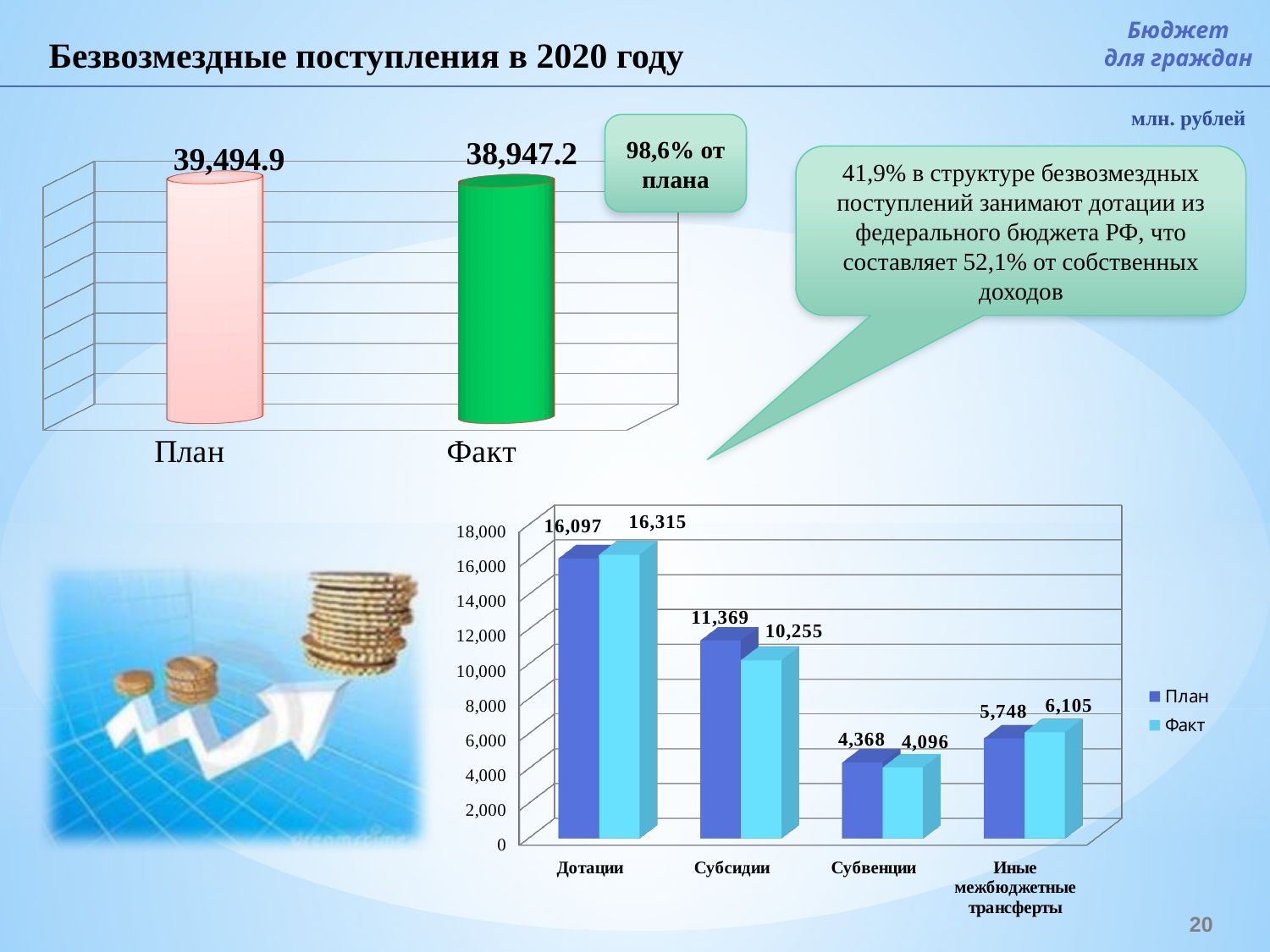
In the bottom chart, which category has the highest План value? Дотации In the top chart, what is the difference between План and Факт? 547.7 In the top chart, which is larger, План or Факт? План In the bottom chart, what is the difference between the План and Факт values for Субсидии? 1,114 In the bottom chart, which category has the lowest Факт value? Субвенции In the bottom chart, what is the Факт value for Иные межбюджетные трансферты? 6,105 How many categories are shown on the x axis of the bottom chart? 4 In the top chart, what is the value for План? 39,494.9 In the bottom chart, what is the План value for Субсидии? 11,369 How many series does the legend of the bottom chart list? 2 In the bottom chart, what is the Факт value for Дотации? 16,315 In the top chart, what is the value for Факт? 38,947.2